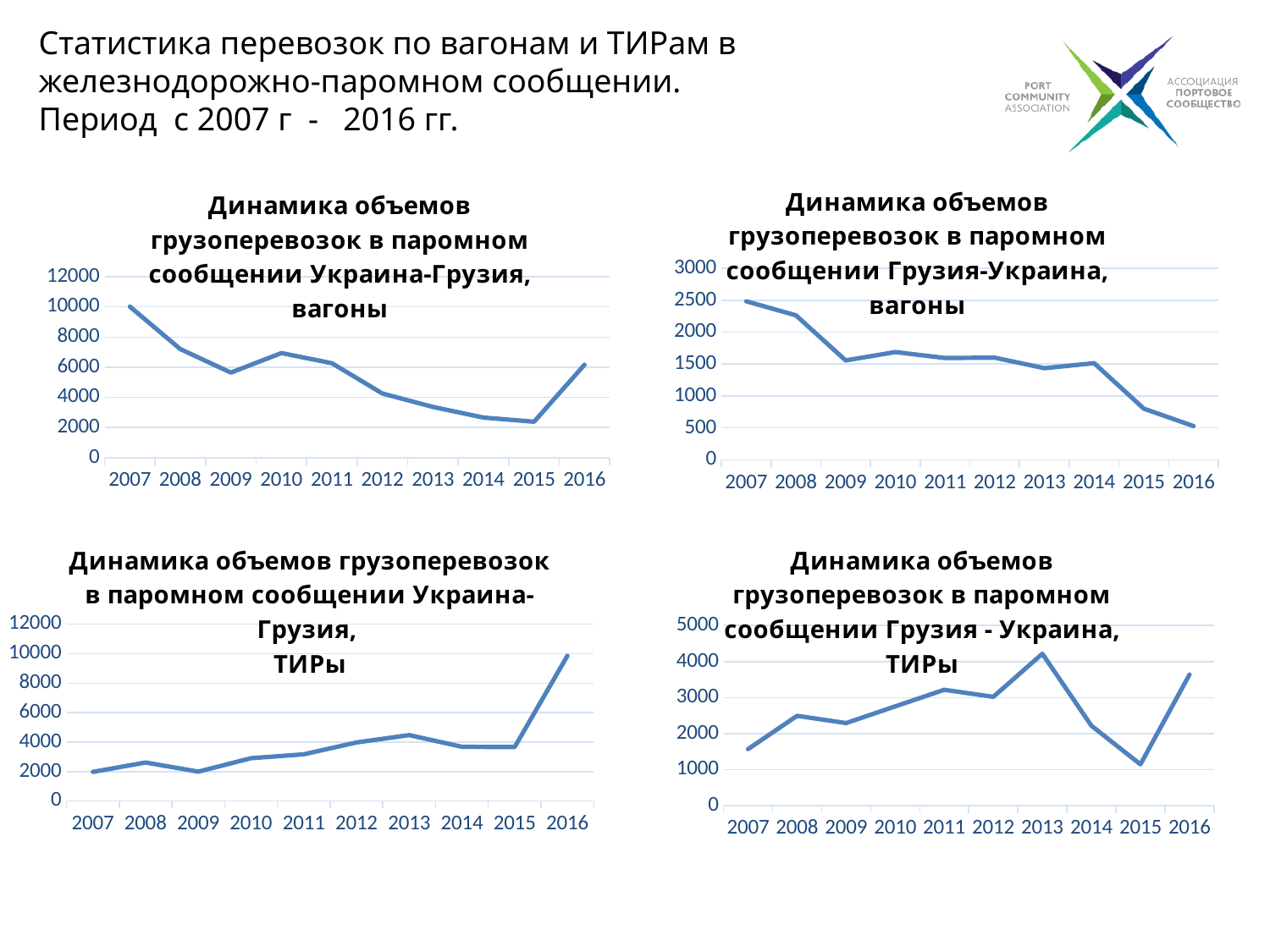
In the top-right chart (Грузия-Украина, вагоны), is the value for 2016 greater or less than 1000? less In the top-right chart (Грузия-Украина, вагоны), do the values generally rise or fall from 2007 to 2016? fall In the bottom-right chart (Грузия - Украина, ТИРы), which year has the lowest value? 2015 What kind of chart is the top-left chart titled "Динамика объемов грузоперевозок в паромном сообщении Украина-Грузия, вагоны"? line chart How many years are plotted on the x axis of the top-right chart (Грузия-Украина, вагоны)? 10 In the top-right chart (Грузия-Украина, вагоны), which year has the lowest value? 2016 In the bottom-right chart (Грузия - Украина, ТИРы), which year has the highest value? 2013 In the top-left chart (Украина-Грузия, вагоны), is the value for 2015 greater or less than 4000? less In the bottom-left chart (Украина-Грузия, ТИРы), which year has the highest value? 2016 In the top-left chart (Украина-Грузия, вагоны), which year has the highest value? 2007 In the top-left chart (Украина-Грузия, вагоны), which is larger, the value for 2007 or the value for 2016? 2007 In the bottom-left chart (Украина-Грузия, ТИРы), is the value for 2016 greater or less than 8000? greater